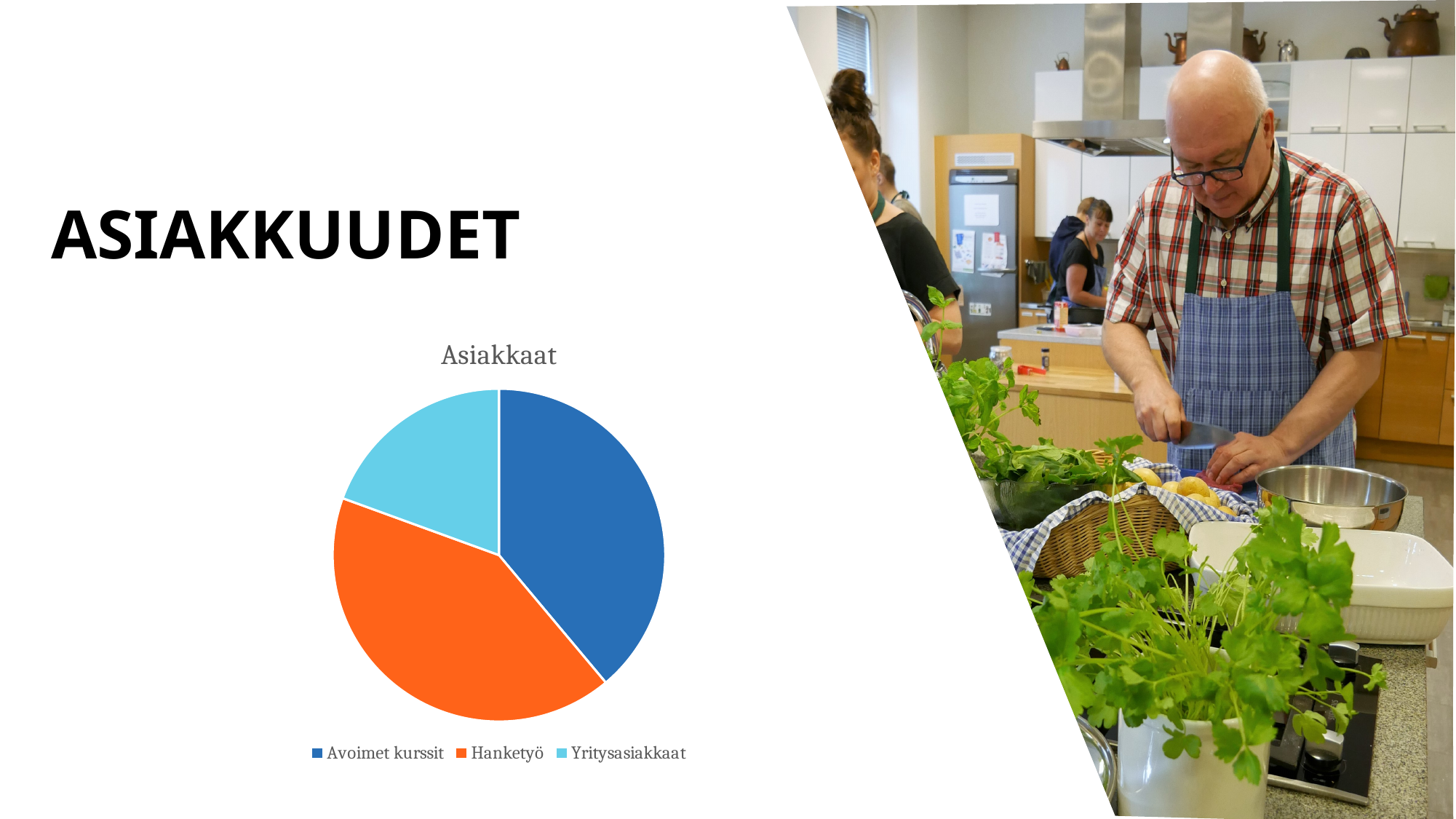
How many slices does the pie chart have? 3 How many entries does the chart legend list? 3 Which category has the smallest slice of the pie? Yritysasiakkaat Which slice is larger, Hanketyö or Yritysasiakkaat? Hanketyö What is the title of the chart? Asiakkaat Which category is shown in orange in the pie chart? Hanketyö Which slice is larger, Avoimet kurssit or Yritysasiakkaat? Avoimet kurssit Is the share of Yritysasiakkaat greater or less than 50% of the pie? less What kind of chart is shown on the slide? pie chart Is the share of Avoimet kurssit greater or less than 25% of the pie? greater